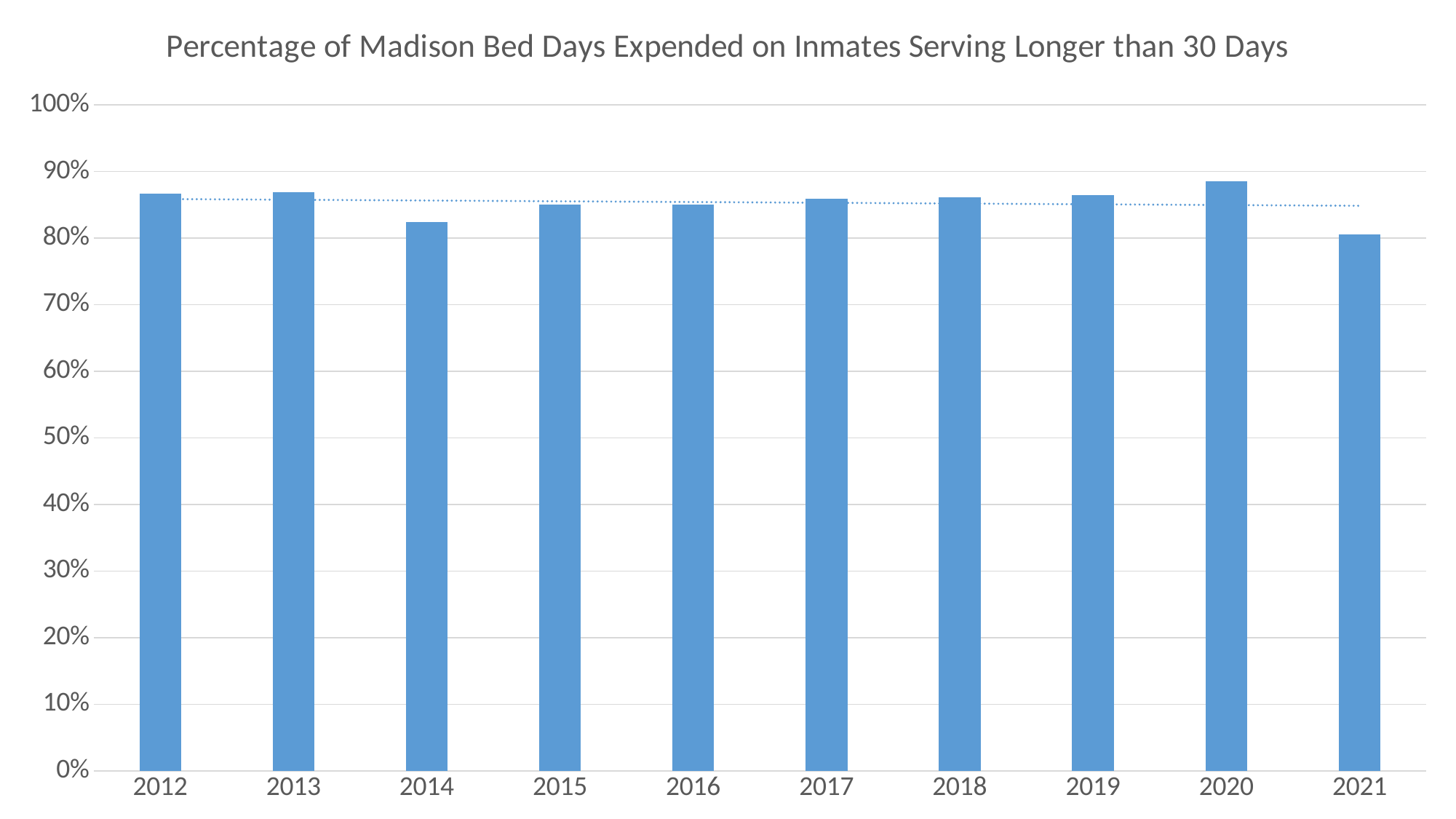
How many years are shown on the x axis of the chart? 10 Is the value for 2021 greater or less than 70%? greater Which year has the larger value, 2013 or 2014? 2013 What is the title of the chart? Percentage of Madison Bed Days Expended on Inmates Serving Longer than 30 Days Is the value for 2014 greater or less than 80%? greater Does the dotted trendline on the chart slope upward or downward from 2012 to 2021? Downward Is the value for 2020 greater or less than 80%? greater What kind of chart is shown on the slide? Bar chart Which year has the highest percentage of bed days expended on inmates serving longer than 30 days? 2020 Which year has the larger value, 2014 or 2021? 2014 Which year has the lowest percentage of bed days expended on inmates serving longer than 30 days? 2021